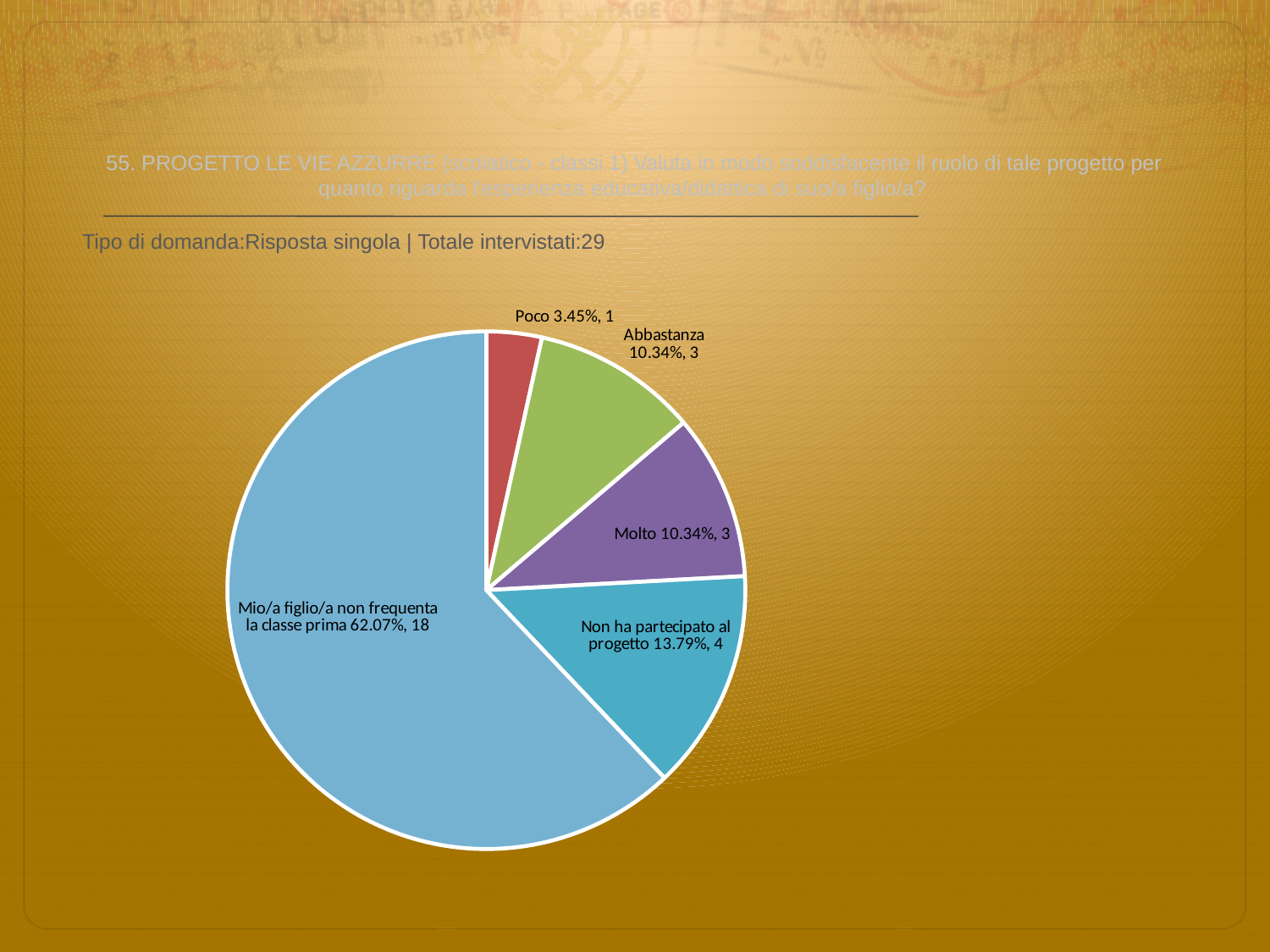
What share of the pie does the "Poco" slice represent? 3.45% What is the total number of respondents across all slices of the pie? 29 How many respondents answered "Non ha partecipato al progetto"? 4 What percentage is shown for "Mio/a figlio/a non frequenta la classe prima"? 62.07% What colour is the "Molto" slice? Purple Which category has the smallest slice of the pie? Poco Which category has the largest slice of the pie? Mio/a figlio/a non frequenta la classe prima How many slices does the pie chart have? 5 What kind of chart is shown on the slide? Pie chart How many respondents answered "Molto"? 3 What is the difference in respondent count between "Non ha partecipato al progetto" and "Abbastanza"? 1 Which has more respondents, "Non ha partecipato al progetto" or "Poco"? Non ha partecipato al progetto